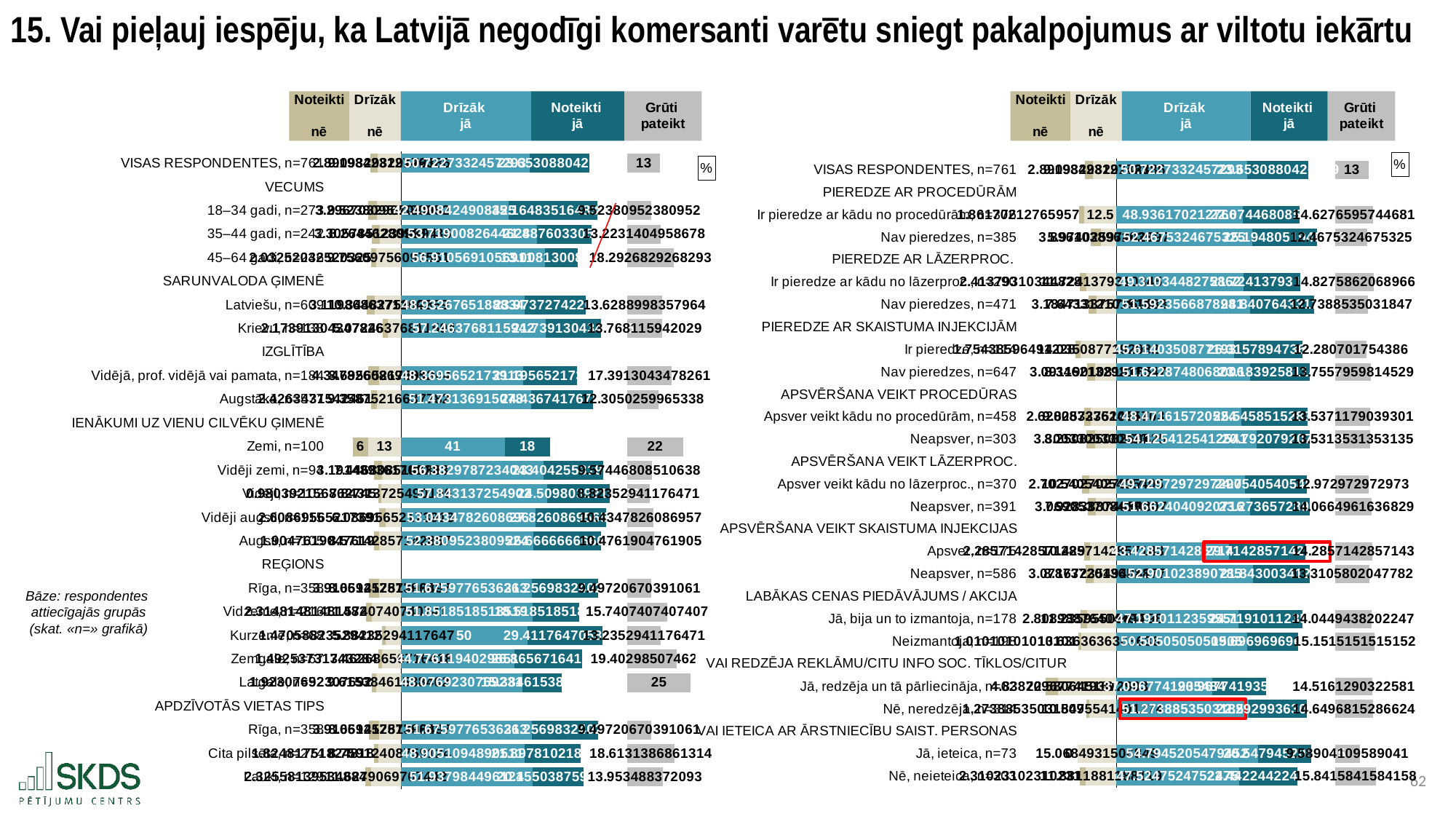
In the left chart, what is the total of the stacked bar for "Zemi, n=100"? 100 In the left chart, what is the value of "Drīzāk jā" for the row "Zemi, n=100"? 41 How many series does the legend of the left chart list? 5 In the left chart, what is the value of "Grūti pateikt" for the row "VISAS RESPONDENTES, n=761"? 13 In the left chart, which series has the largest value in the row "Zemi, n=100"? Drīzāk jā What kind of chart is shown on the left side of the slide? bar chart In the left chart, what is the value of "Drīzāk nē" for the row "Zemi, n=100"? 13 In the left chart, what is the difference between "Drīzāk jā" and "Noteikti jā" for the row "Zemi, n=100"? 23 In the left chart, what is the value of "Noteikti jā" for the row "Zemi, n=100"? 18 In the left chart, what is the value of "Noteikti nē" for the row "Zemi, n=100"? 6 In the left chart, which series has the smallest value in the row "Zemi, n=100"? Noteikti nē In the left chart, what is the value of "Grūti pateikt" for the row "Zemi, n=100"? 22